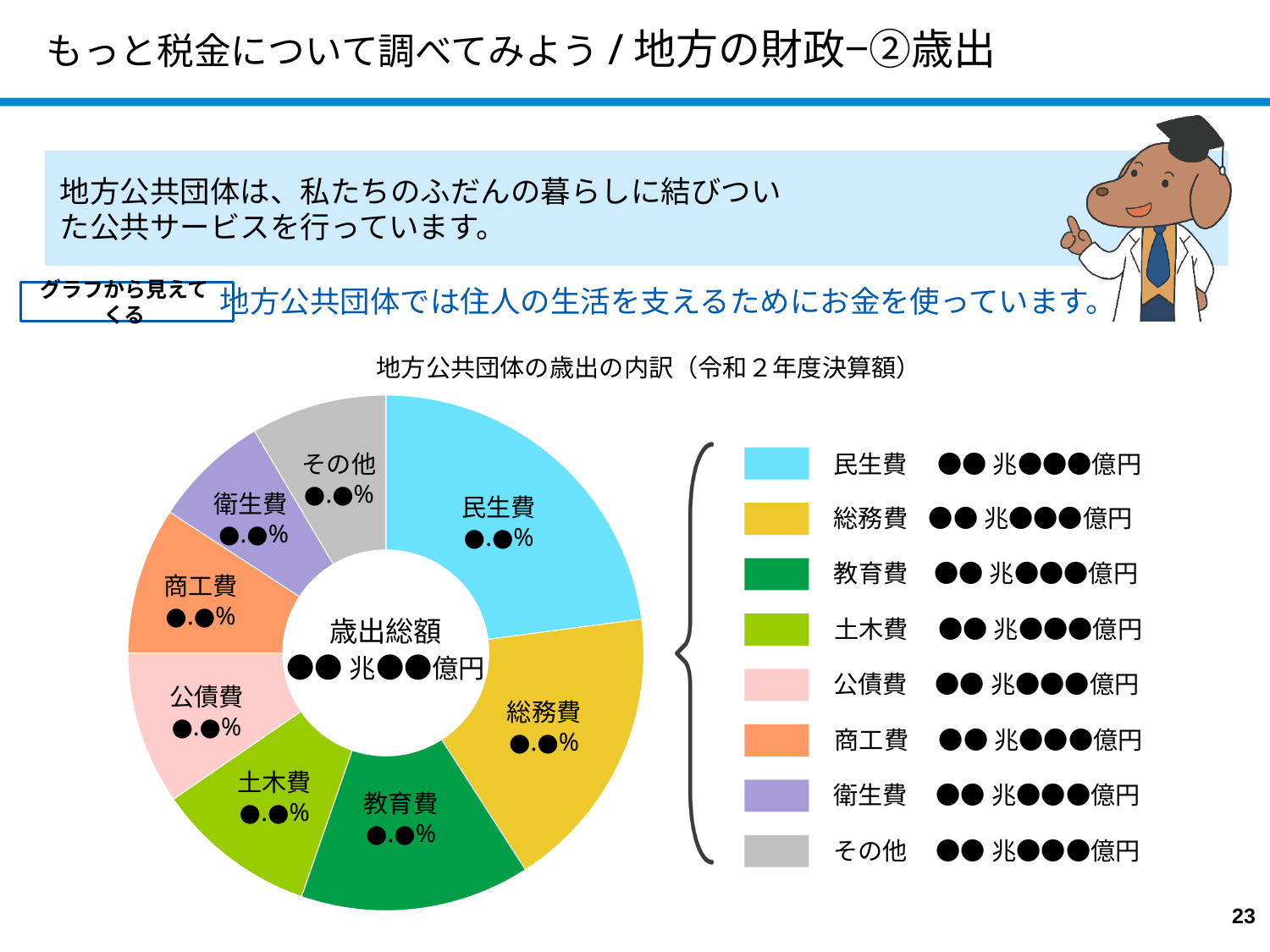
What colour is the 民生費 slice in the pie chart? Light blue How many entries does the legend to the right of the pie chart list? 8 Which slice is larger, 民生費 or 教育費? 民生費 What kind of chart is shown on the slide? Pie (donut) chart What is the title of the pie chart? 地方公共団体の歳出の内訳（令和２年度決算額） Which category has the largest slice of the pie chart? 民生費 Which slice is larger, 民生費 or 衛生費? 民生費 Which slice is larger, 総務費 or その他? 総務費 How many categories does the pie chart divide local government expenditure into? 8